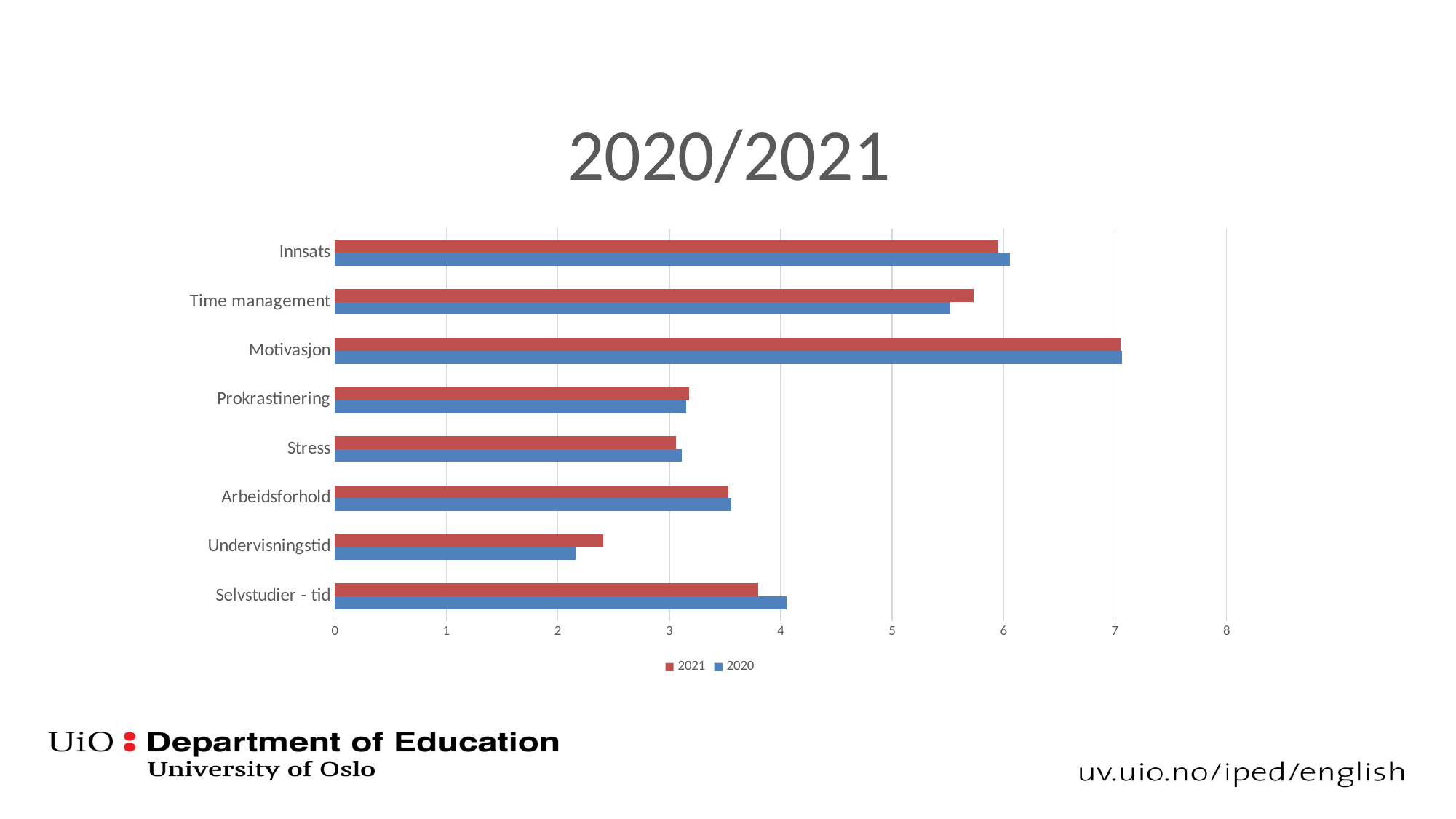
Is the 2020 value for Time management greater or less than 5? greater What is the title of the chart? 2020/2021 How many series does the legend list? 2 Which colour represents the 2020 series in the legend? blue Which category has the highest value for the 2021 series? Motivasjon Which category has the lowest value for the 2020 series? Undervisningstid For Undervisningstid, which series has the larger value, 2021 or 2020? 2021 Is the 2020 value for Arbeidsforhold greater or less than 4? less What kind of chart is shown on the slide? bar chart For Selvstudier - tid, which series has the larger value, 2021 or 2020? 2020 Is the 2021 value for Selvstudier - tid greater or less than 4? less How many categories are shown on the chart? 8